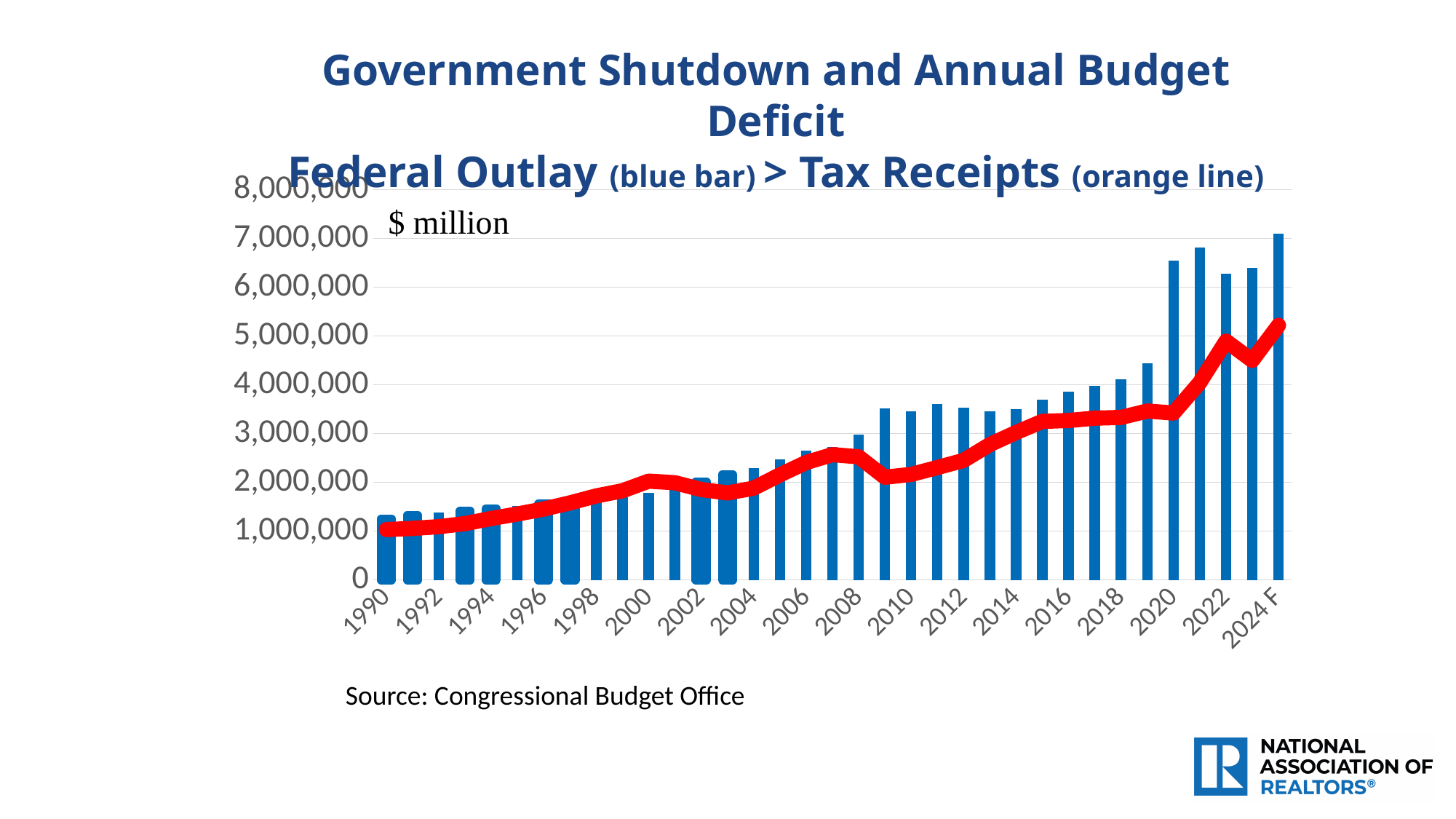
What unit is shown for the values on the chart? $ million Is the Tax Receipts value for 2009 greater or less than 3,000,000? less Do the Federal Outlay bars generally rise or fall from 1990 to 2024 F? Rise Is the Tax Receipts value for 2022 greater or less than 4,000,000? greater Is the Federal Outlay for 2000 greater or less than 2,000,000? less Which year has the higher Federal Outlay, 2008 or 2009? 2009 Which year has the tallest blue bar (highest Federal Outlay)? 2024 F Which year has the shortest blue bar (lowest Federal Outlay)? 1990 What kind of chart is shown on the slide? A combined bar and line chart What is the title of the chart on the slide? Government Shutdown and Annual Budget Deficit